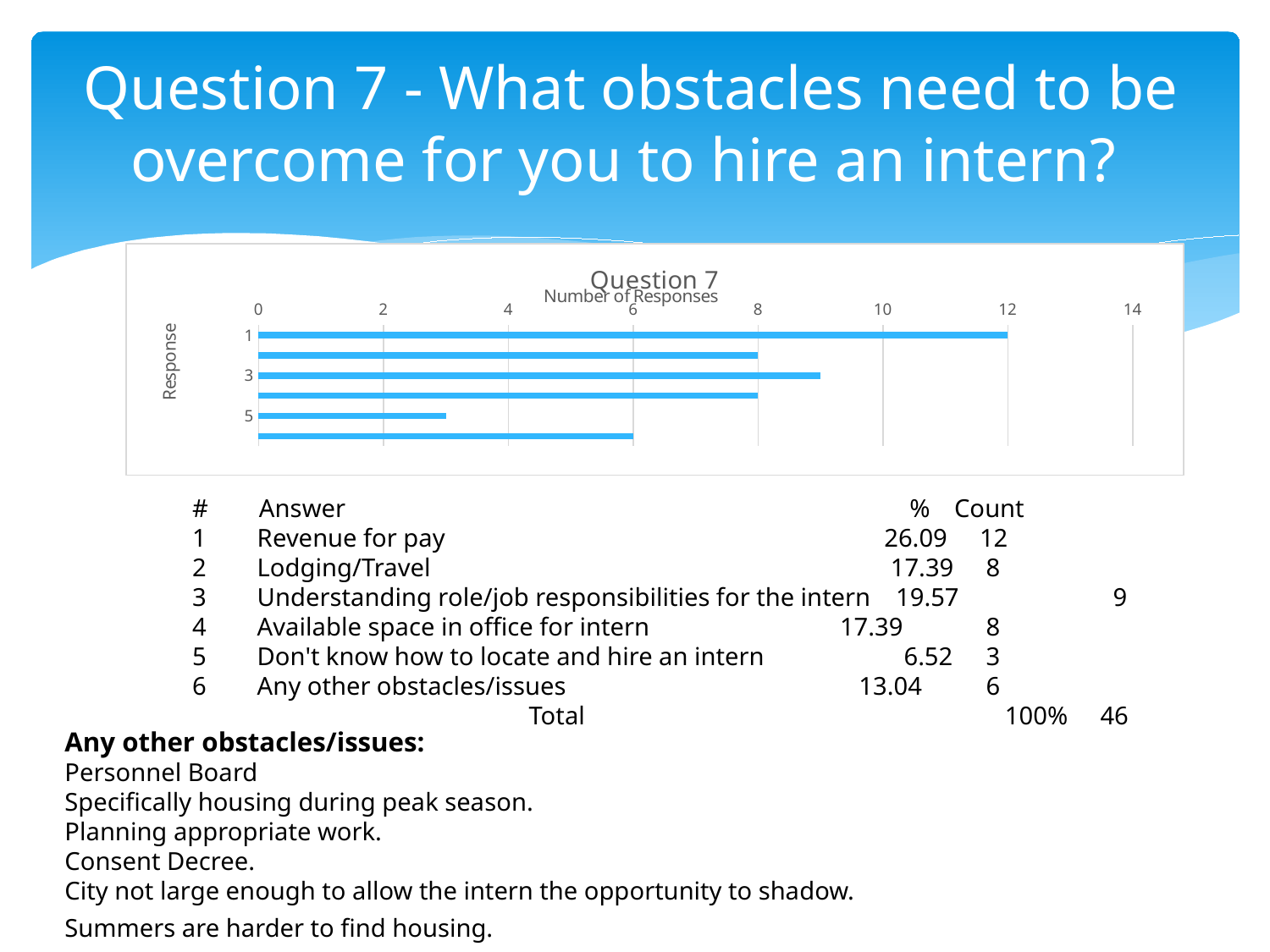
What is the label of the horizontal axis of the chart? Number of Responses How many bars are plotted in the chart? 6 Which has more responses, Response 1 or Response 3? Response 1 What is the title of the chart? Question 7 Is the number of responses for Response 3 greater or less than 8? greater Is the number of responses for Response 5 greater or less than 4? less Which response has the highest number of responses? 1 What is the number of responses for the bottom bar (Response 6)? 6 Which response has the lowest number of responses? 5 What kind of chart is shown on the slide? bar chart Is the number of responses for Response 1 greater or less than 10? greater What is the number of responses for Response 1? 12